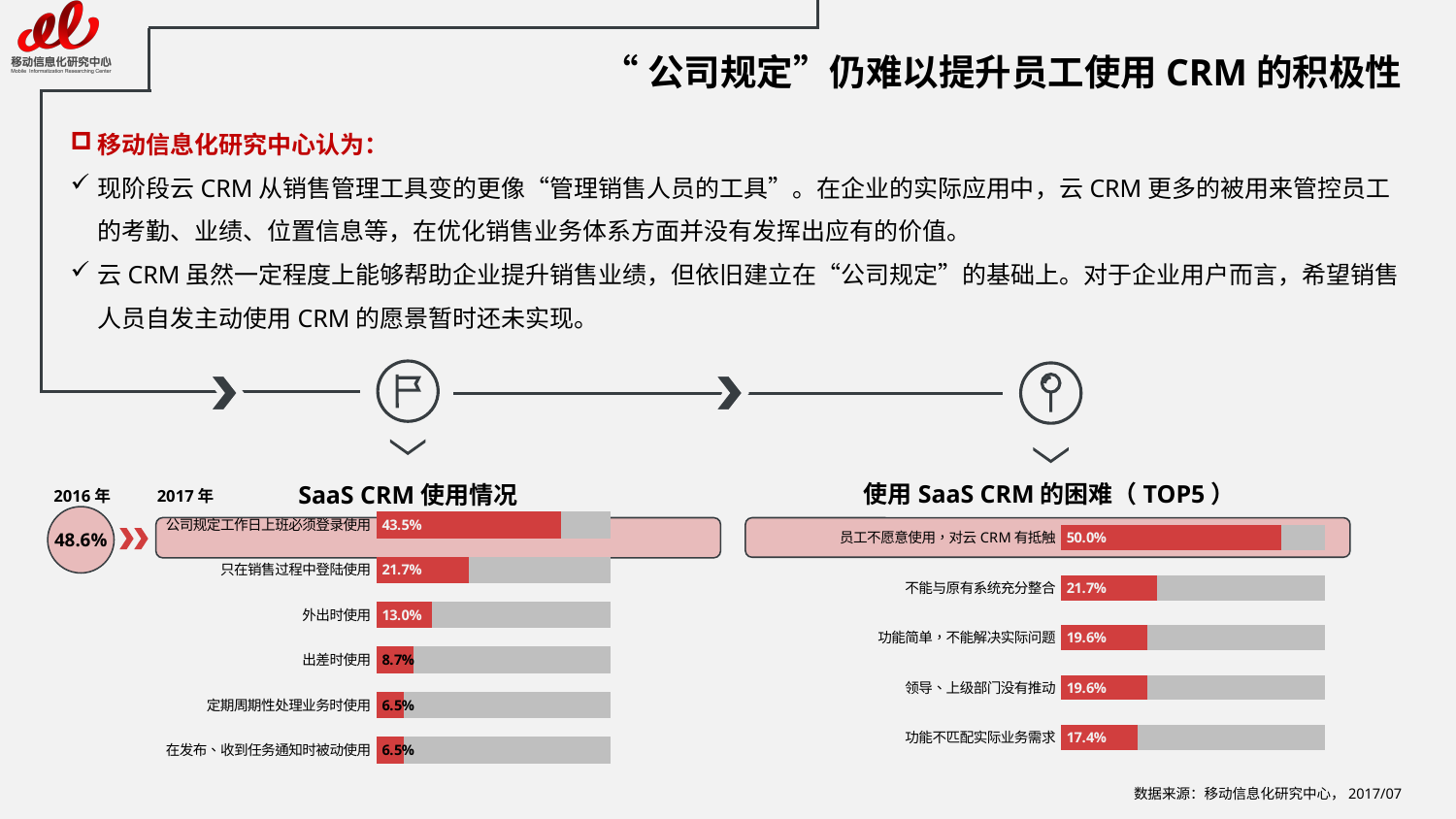
In the "使用 SaaS CRM 的困难（TOP5）" chart, which category has the lowest value? 功能不匹配实际业务需求 What type of chart is the "使用 SaaS CRM 的困难（TOP5）" chart? Bar chart In the "使用 SaaS CRM 的困难（TOP5）" chart, what is the difference between 员工不愿意使用，对云 CRM 有抵触 and 不能与原有系统充分整合? 28.3% In the "使用 SaaS CRM 的困难（TOP5）" chart, how many categories are shown? 5 In the "SaaS CRM 使用情况" chart, what is the difference between 只在销售过程中登陆使用 and 出差时使用? 13.0% In the "SaaS CRM 使用情况" chart, what was the 2016 value for 公司规定工作日上班必须登录使用? 48.6% In the "SaaS CRM 使用情况" chart, how many categories are shown? 6 In the "SaaS CRM 使用情况" chart, what is the value for 外出时使用? 13.0% In the "SaaS CRM 使用情况" chart, what is the value for 公司规定工作日上班必须登录使用? 43.5% In the "SaaS CRM 使用情况" chart, which category has the highest value? 公司规定工作日上班必须登录使用 In the "使用 SaaS CRM 的困难（TOP5）" chart, what is the value for 功能不匹配实际业务需求? 17.4% In the "使用 SaaS CRM 的困难（TOP5）" chart, what is the value for 员工不愿意使用，对云 CRM 有抵触? 50.0%